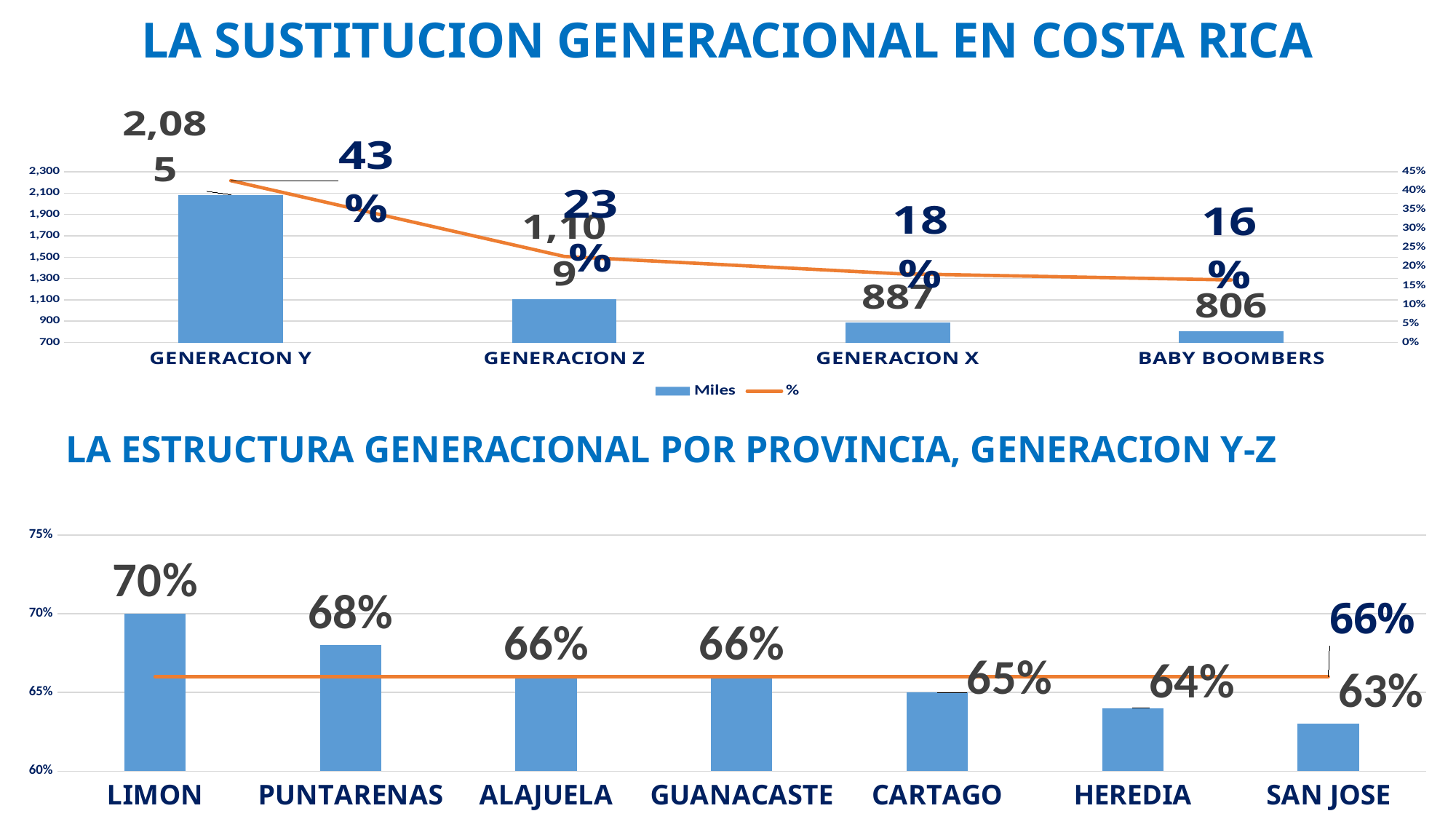
In the chart 'LA ESTRUCTURA GENERACIONAL POR PROVINCIA, GENERACION Y-Z', what is the value for PUNTARENAS? 68% In the chart 'LA SUSTITUCION GENERACIONAL EN COSTA RICA', what percentage is shown for GENERACION Z? 23% In the chart 'LA ESTRUCTURA GENERACIONAL POR PROVINCIA, GENERACION Y-Z', what is the difference between the values for LIMON and SAN JOSE? 7% In the chart 'LA SUSTITUCION GENERACIONAL EN COSTA RICA', which generation has the lowest Miles value? BABY BOOMBERS In the chart 'LA ESTRUCTURA GENERACIONAL POR PROVINCIA, GENERACION Y-Z', how many provinces are shown? 7 In the chart 'LA ESTRUCTURA GENERACIONAL POR PROVINCIA, GENERACION Y-Z', which province has the highest value? LIMON In the chart 'LA SUSTITUCION GENERACIONAL EN COSTA RICA', what is the difference in Miles between GENERACION X and BABY BOOMBERS? 81 In the chart 'LA ESTRUCTURA GENERACIONAL POR PROVINCIA, GENERACION Y-Z', which province has the lowest value? SAN JOSE In the chart 'LA ESTRUCTURA GENERACIONAL POR PROVINCIA, GENERACION Y-Z', which is larger, the value for CARTAGO or the value for HEREDIA? CARTAGO In the chart 'LA SUSTITUCION GENERACIONAL EN COSTA RICA', what is the Miles value for GENERACION X? 887 In the chart 'LA SUSTITUCION GENERACIONAL EN COSTA RICA', how many series does the legend list? 2 In the chart 'LA SUSTITUCION GENERACIONAL EN COSTA RICA', does the percentage line rise or fall from GENERACION Y to BABY BOOMBERS? fall